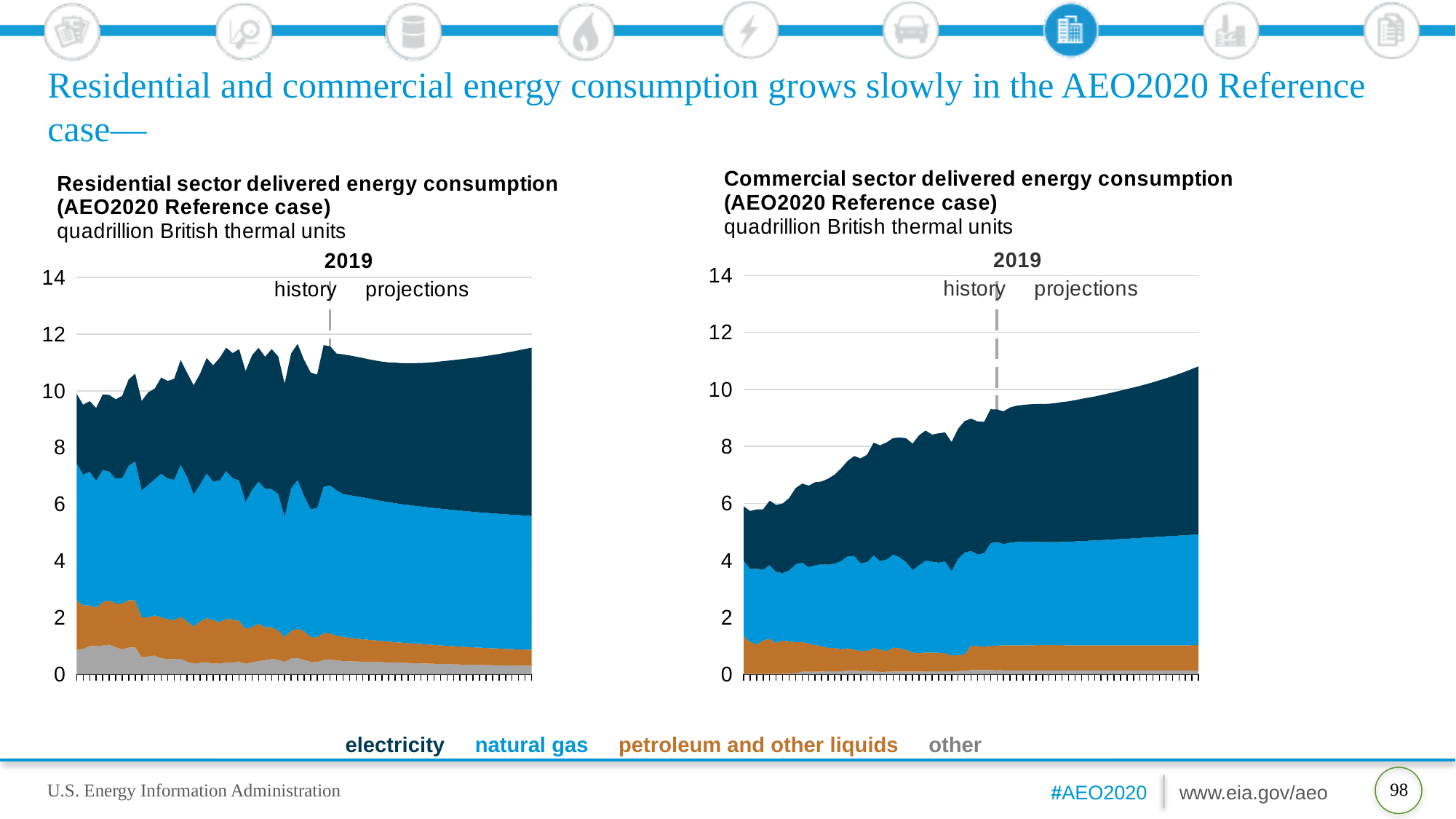
In the Residential sector delivered energy consumption chart, which fuel is the smallest component of consumption at the end of the projection period? other In the Commercial sector delivered energy consumption chart, which fuel is the largest component of consumption at the end of the projection period? electricity In the Commercial sector delivered energy consumption chart, is the total delivered energy consumption at the start of the history period greater or less than 8? less What unit is used on the y axis of both charts? quadrillion British thermal units In the Residential sector delivered energy consumption chart, does natural gas consumption rise or fall over the projection period? fall In which year does the dashed line separating history from projections fall on both charts? 2019 In the Commercial sector delivered energy consumption chart, does total delivered energy consumption rise or fall over the projection period? rise In the Commercial sector delivered energy consumption chart, is the total delivered energy consumption at the end of the projection period greater or less than 10? greater At the start of the history period, which sector has the larger total delivered energy consumption, residential or commercial? residential In the Residential sector delivered energy consumption chart, is the total delivered energy consumption at the end of the projection period greater or less than 10? greater How many series does the shared legend list for the two charts? 4 What kind of chart is the Residential sector delivered energy consumption chart? stacked area chart